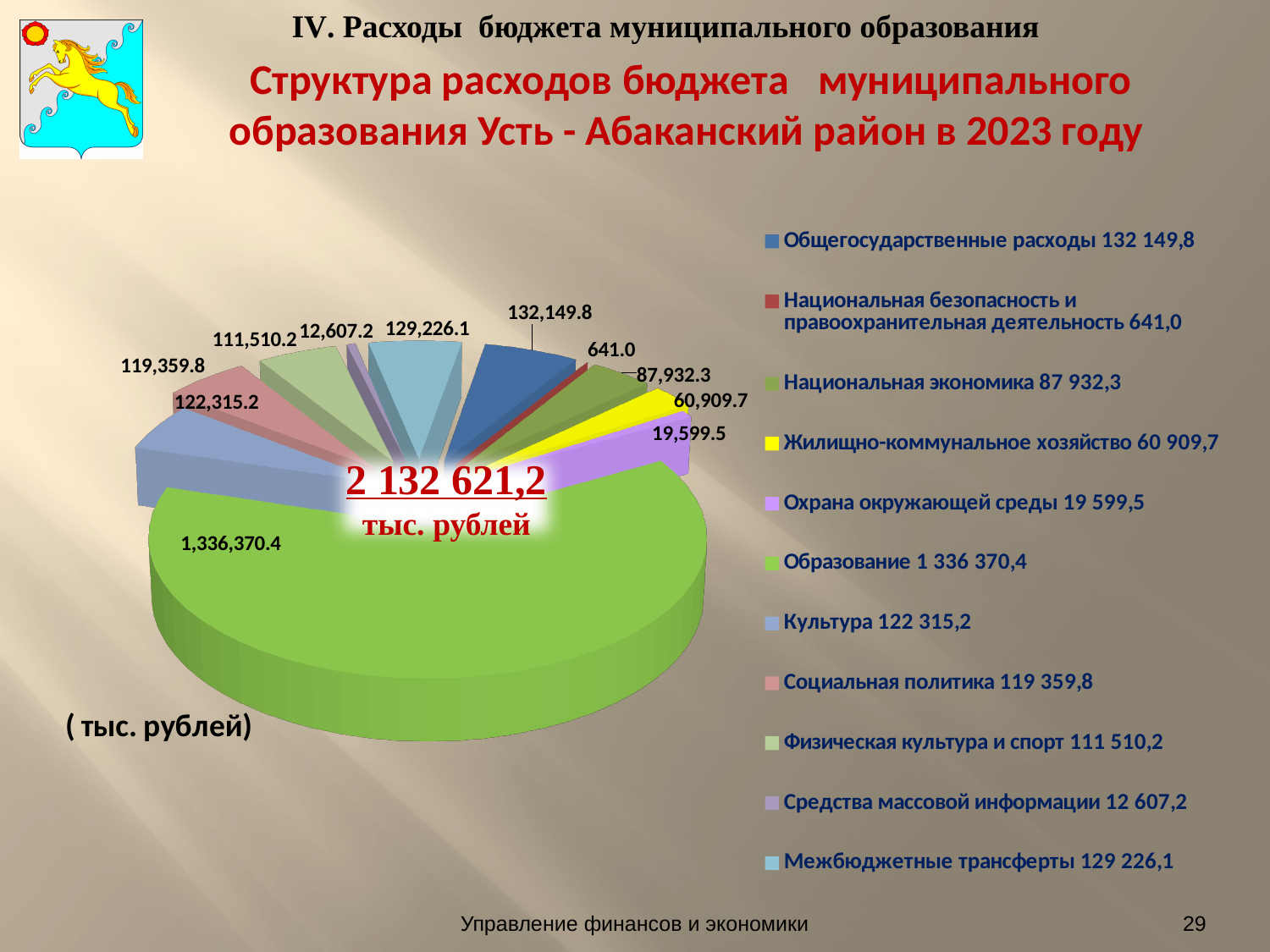
What unit is stated for the values in the pie chart? тыс. рублей Which category has the smallest value in the pie chart? Национальная безопасность и правоохранительная деятельность What is the value for Образование? 1,336,370.4 What is the value for Жилищно-коммунальное хозяйство? 60,909.7 Which is larger, Культура or Социальная политика? Культура What is the value for Межбюджетные трансферты? 129,226.1 What is the difference between Общегосударственные расходы and Межбюджетные трансферты? 2,923.7 How many categories does the pie chart have? 11 What total is printed in the centre of the pie chart? 2 132 621,2 тыс. рублей Which category has the largest share of the pie chart? Образование What kind of chart is shown on the slide? pie chart What is the value for Средства массовой информации? 12,607.2